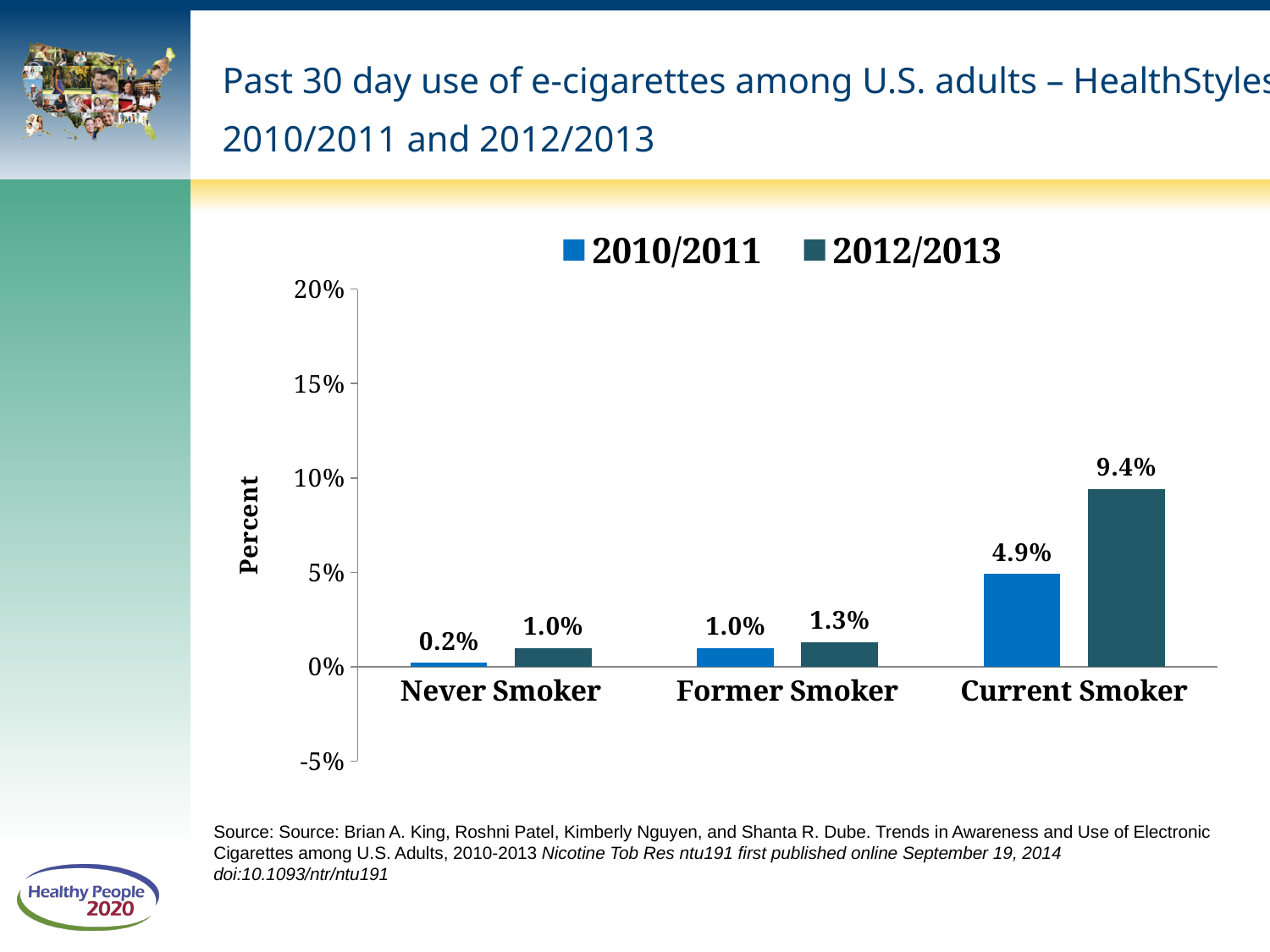
What is the value for Former Smoker in 2012/2013? 1.3% Which is larger: the 2012/2013 value for Never Smoker or the 2012/2013 value for Former Smoker? Former Smoker Which category has the highest value in the 2012/2013 series? Current Smoker What is the label of the y axis? Percent What is the value for Never Smoker in 2010/2011? 0.2% What is the value for Current Smoker in 2012/2013? 9.4% Is the 2010/2011 value for Current Smoker greater or less than 5%? less How many series does the legend list? 2 How many categories are shown on the x axis? 3 Which category has the lowest value in the 2010/2011 series? Never Smoker What kind of chart is shown on the slide? bar chart What is the difference between the 2012/2013 and 2010/2011 values for Current Smoker? 4.5%